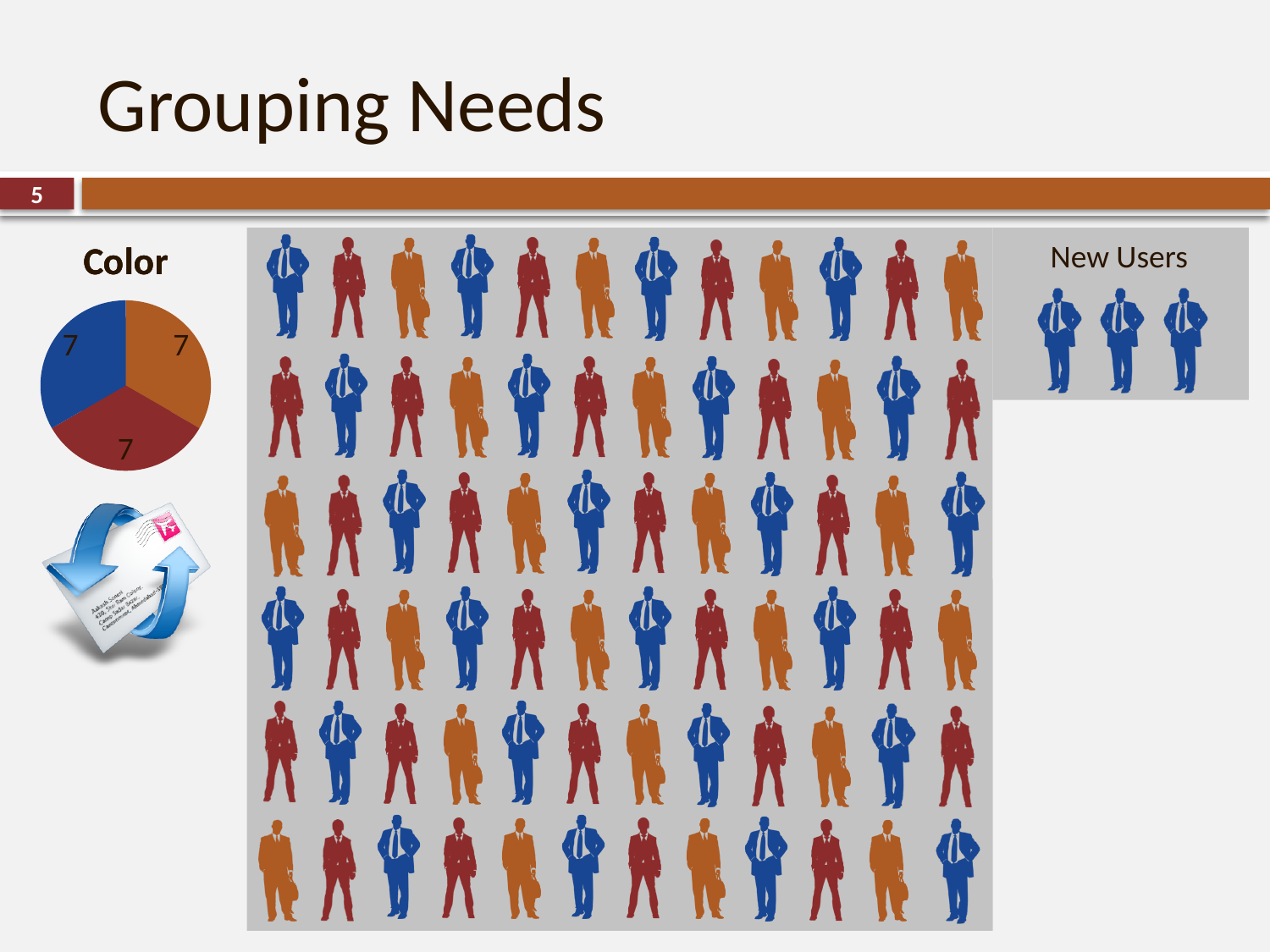
Is the value of the red slice in the "Color" pie chart greater or less than 10? less In the "Color" pie chart, is the blue slice larger than, smaller than, or equal to the orange slice? equal What value is shown on the blue slice of the "Color" pie chart? 7 Which three colours are used for the slices of the "Color" pie chart? blue, orange and red What is the total of all the slice values in the "Color" pie chart? 21 What is the title of the pie chart on the left of the slide? Color What kind of chart is the chart titled "Color"? pie chart What is the difference between the value of the blue slice and the value of the red slice in the "Color" pie chart? 0 What value is shown on the red slice of the "Color" pie chart? 7 How many slices does the "Color" pie chart have? 3 What value is shown on the orange slice of the "Color" pie chart? 7